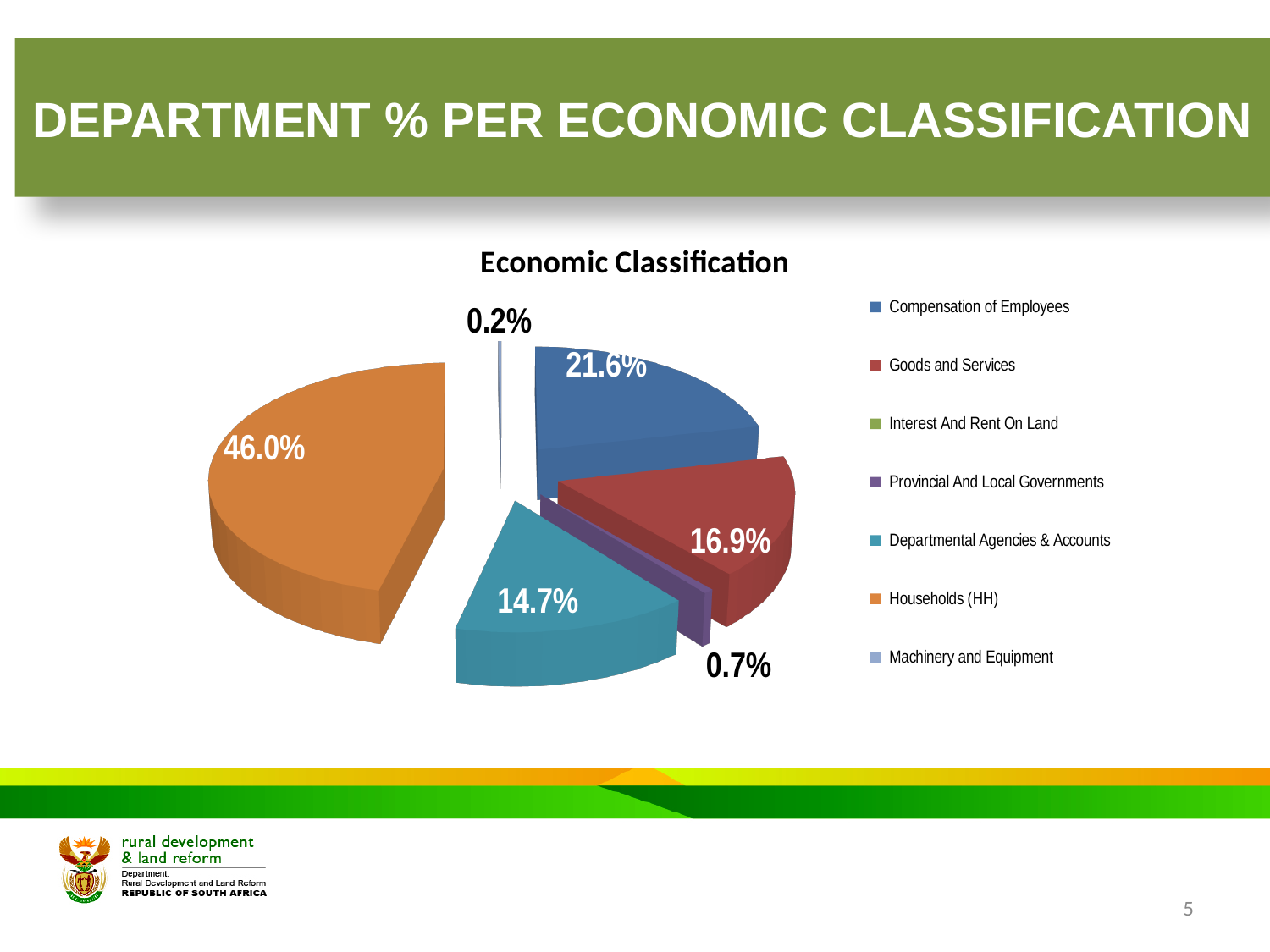
What percentage does the pie chart show for Compensation of Employees? 21.6% Which is larger: the share for Goods and Services or the share for Departmental Agencies & Accounts? Goods and Services How many categories does the chart legend list? 7 What percentage does the pie chart show for Departmental Agencies & Accounts? 14.7% What kind of chart is shown on the slide? Pie chart What is the title of the chart? Economic Classification What percentage does the pie chart show for Goods and Services? 16.9% Which economic classification has the largest share of the pie? Households (HH) By how many percentage points does Compensation of Employees exceed Goods and Services? 4.7 percentage points What percentage does the pie chart show for Provincial And Local Governments? 0.7% By how many percentage points does Households (HH) exceed Compensation of Employees? 24.4 percentage points What percentage does the pie chart show for Households (HH)? 46.0%